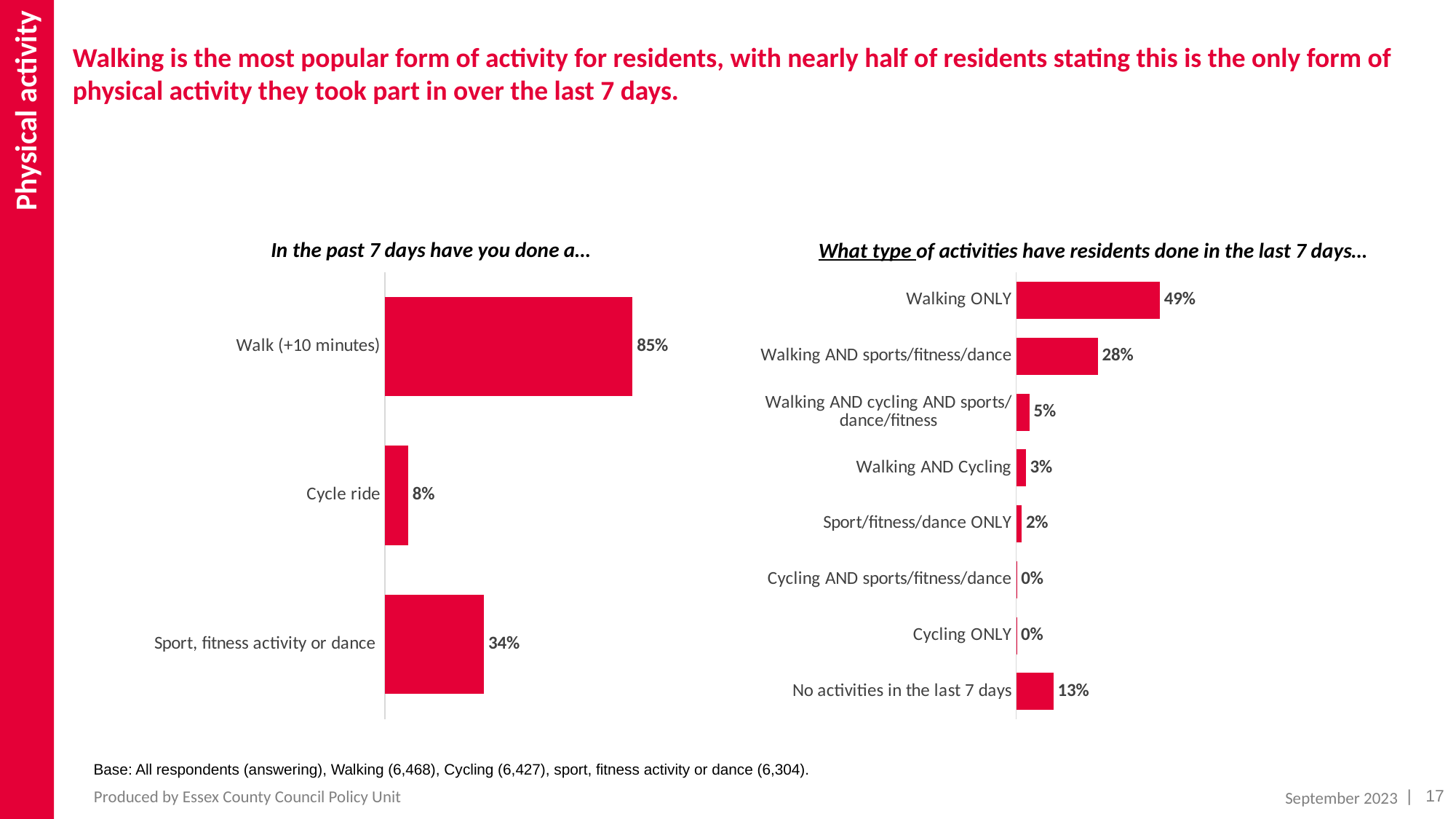
What type of chart is the left chart 'In the past 7 days have you done a...'? Bar chart In the right chart 'What type of activities have residents done in the last 7 days...', which category has the highest value? Walking ONLY In the right chart 'What type of activities have residents done in the last 7 days...', what is the difference between Walking ONLY and Walking AND sports/fitness/dance? 21% In the left chart 'In the past 7 days have you done a...', how many categories are shown? 3 In the right chart 'What type of activities have residents done in the last 7 days...', which is larger: Walking AND Cycling or Sport/fitness/dance ONLY? Walking AND Cycling In the left chart 'In the past 7 days have you done a...', what is the value for Walk (+10 minutes)? 85% In the right chart 'What type of activities have residents done in the last 7 days...', what is the value for No activities in the last 7 days? 13% In the left chart 'In the past 7 days have you done a...', what is the difference between Walk (+10 minutes) and Sport, fitness activity or dance? 51% In the left chart 'In the past 7 days have you done a...', which category has the lowest value? Cycle ride In the left chart 'In the past 7 days have you done a...', what is the value for Cycle ride? 8% In the right chart 'What type of activities have residents done in the last 7 days...', what is the value for Walking AND sports/fitness/dance? 28% In the right chart 'What type of activities have residents done in the last 7 days...', how many categories are shown? 8